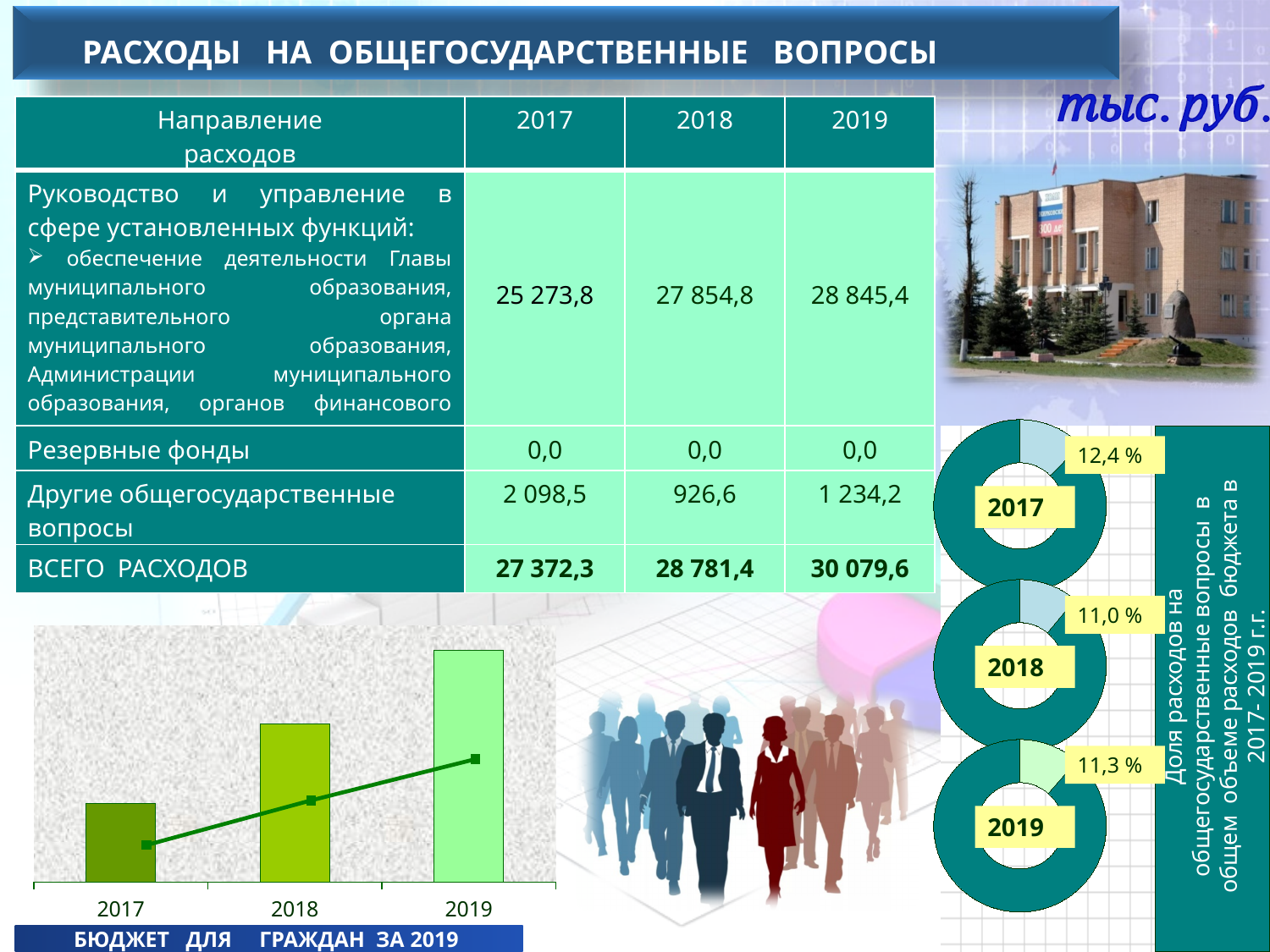
In the donut charts on the right, what share is shown for 2019? 11,3 % What kind of chart is shown at the bottom left of the slide? bar chart In the donut charts on the right, what share is shown for 2018? 11,0 % In the bar chart at the bottom left, is the bar for 2018 taller or shorter than the bar for 2017? taller In the bar chart at the bottom left, which year has the tallest bar? 2019 Among the donut charts on the right, which year has the highest share? 2017 In the donut charts on the right, what share is shown for 2017? 12,4 % In the bar chart at the bottom left, how many years are shown on the x axis? 3 In the bar chart at the bottom left, does the line plotted over the bars go up or down from 2017 to 2019? up In the bar chart at the bottom left, which year has the shortest bar? 2017 Among the donut charts on the right, which year has the lowest share? 2018 In the bar chart at the bottom left, do the bars rise or fall from 2017 to 2019? rise